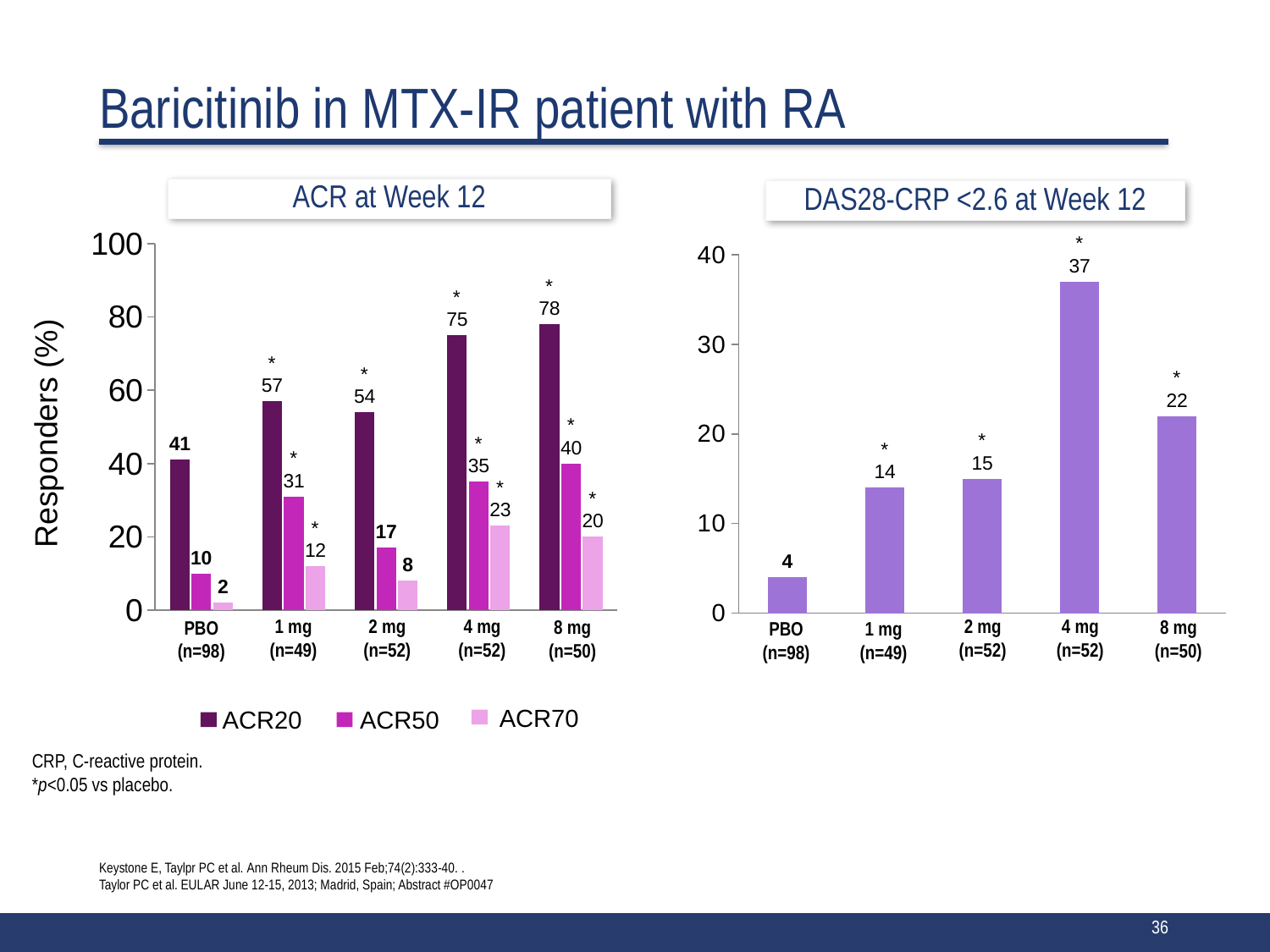
In the 'DAS28-CRP <2.6 at Week 12' chart, what is the value for the 4 mg group? 37 In the 'DAS28-CRP <2.6 at Week 12' chart, how many dose groups are shown on the x axis? 5 In the 'ACR at Week 12' chart, what is the difference between the ACR20 values for the 1 mg group and the PBO group? 16 In the 'DAS28-CRP <2.6 at Week 12' chart, what is the difference between the 4 mg and 8 mg values? 15 In the 'ACR at Week 12' chart, how many series does the legend list? 3 What kind of chart is the 'DAS28-CRP <2.6 at Week 12' chart? Bar chart In the 'ACR at Week 12' chart, which dose group has the highest ACR20 value? 8 mg In the 'ACR at Week 12' chart, which group has the lowest ACR70 value? PBO In the 'ACR at Week 12' chart, what is the ACR70 value for the PBO group? 2 In the 'ACR at Week 12' chart, what is the ACR50 value for the 4 mg group? 35 In the 'ACR at Week 12' chart, what is the ACR20 value for the 8 mg group? 78 In the 'DAS28-CRP <2.6 at Week 12' chart, which group has the lowest value? PBO